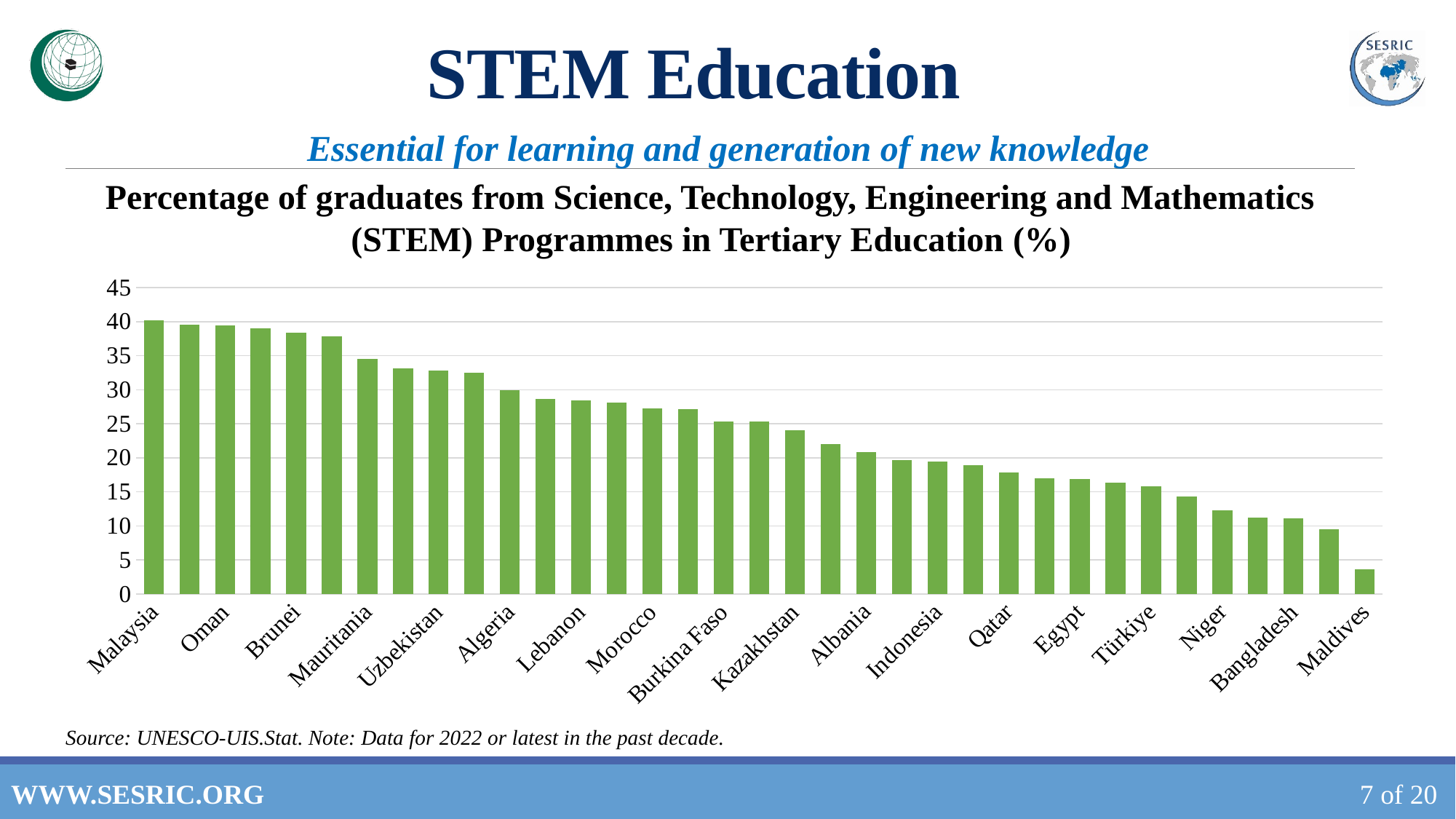
Which has a higher percentage of STEM graduates, Uzbekistan or Algeria? Uzbekistan Is the value for Maldives greater or less than 5? less Is the value for Niger greater or less than 10? greater Which country has the highest percentage of STEM graduates in the chart? Malaysia What colour are the bars in the chart? Green Is the value for Qatar greater or less than 20? less Which country has the lowest percentage of STEM graduates in the chart? Maldives Do the values rise or fall moving from left to right along the x axis? Fall What kind of chart is shown on the slide? Bar chart